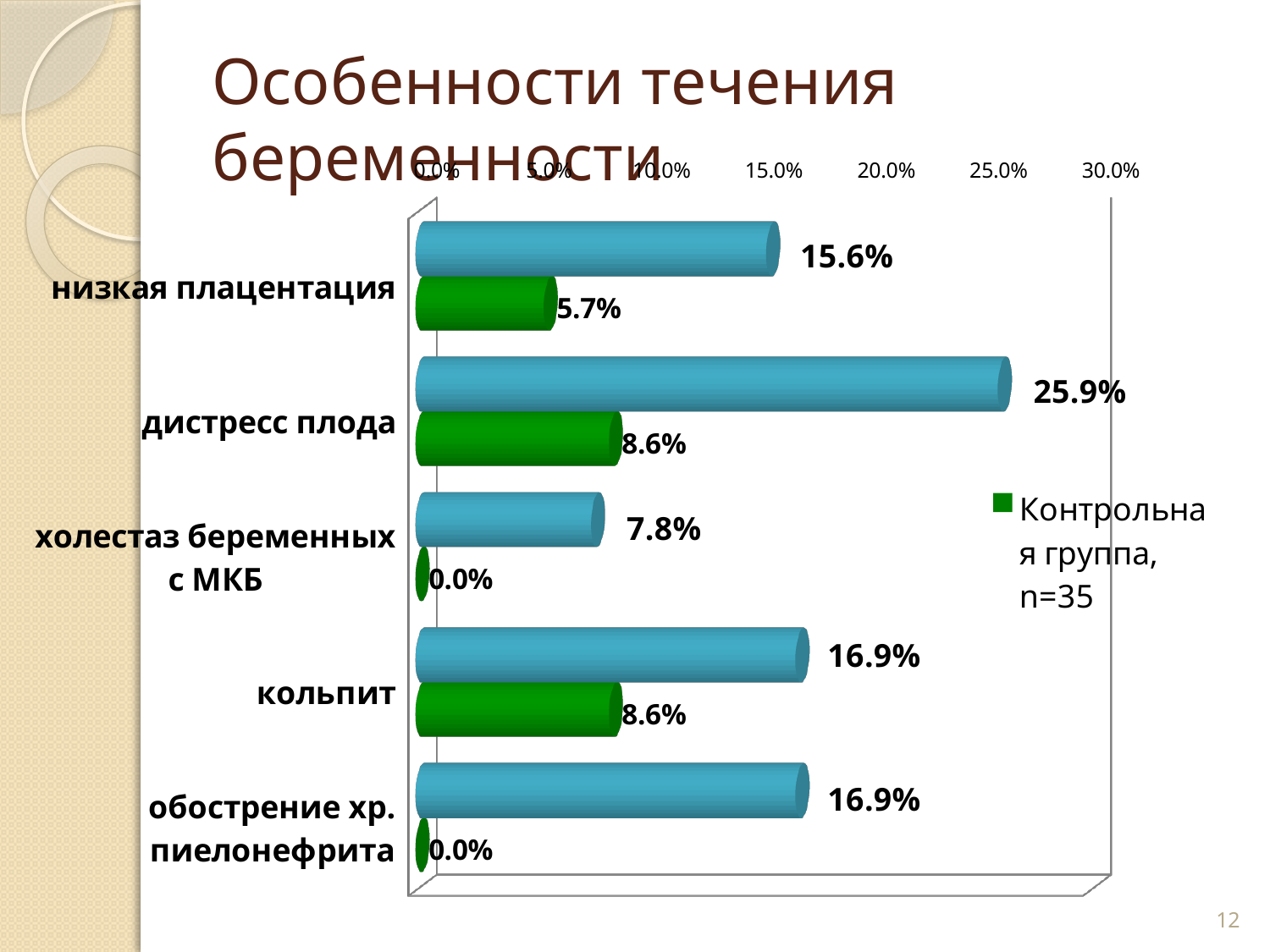
Which category has the highest value among the blue bars? дистресс плода What is the value of the blue bar for дистресс плода? 25.9% What is the legend entry shown for the green bars? Контрольная группа, n=35 What is the value for the control group (Контрольная группа, n=35) for низкая плацентация? 5.7% What is the value for the control group (Контрольная группа, n=35) for обострение хр. пиелонефрита? 0.0% Which category has the lowest value among the blue bars? холестаз беременных с МКБ Is the blue bar value for холестаз беременных с МКБ greater or less than 10.0%? less What kind of chart is shown on the slide? bar chart How many categories are shown on the chart? 5 Among the blue bars, which is larger: кольпит or низкая плацентация? кольпит What is the value for the control group (Контрольная группа, n=35) for кольпит? 8.6% For дистресс плода, what is the difference between the blue bar value and the control group value? 17.3 percentage points